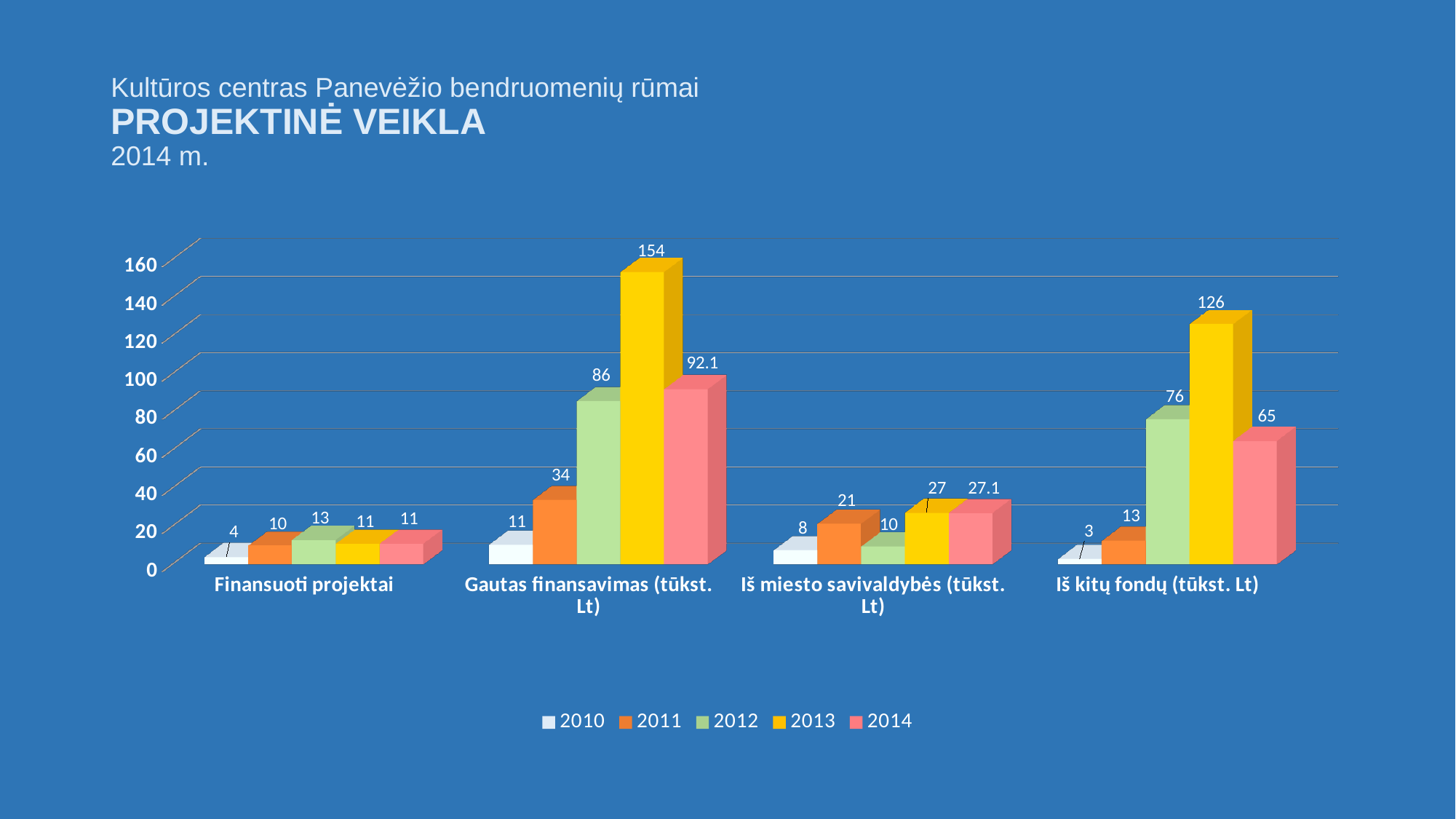
How many series does the legend list? 5 What is the difference between the 2013 and 2014 values in the "Gautas finansavimas (tūkst. Lt)" category? 61.9 How many categories are shown on the x axis? 4 Which year has the lowest value in the "Gautas finansavimas (tūkst. Lt)" category? 2010 Which colour represents the 2013 series in the legend? Yellow Which is larger in the "Iš miesto savivaldybės (tūkst. Lt)" category: the 2011 value or the 2012 value? 2011 What is the value for 2014 in the "Iš miesto savivaldybės (tūkst. Lt)" category? 27.1 What is the value for 2013 in the "Gautas finansavimas (tūkst. Lt)" category? 154 Which year has the highest value in the "Iš kitų fondų (tūkst. Lt)" category? 2013 What is the value for 2014 in the "Iš kitų fondų (tūkst. Lt)" category? 65 What kind of chart is shown on the slide? Bar chart What is the value for 2010 in the "Finansuoti projektai" category? 4